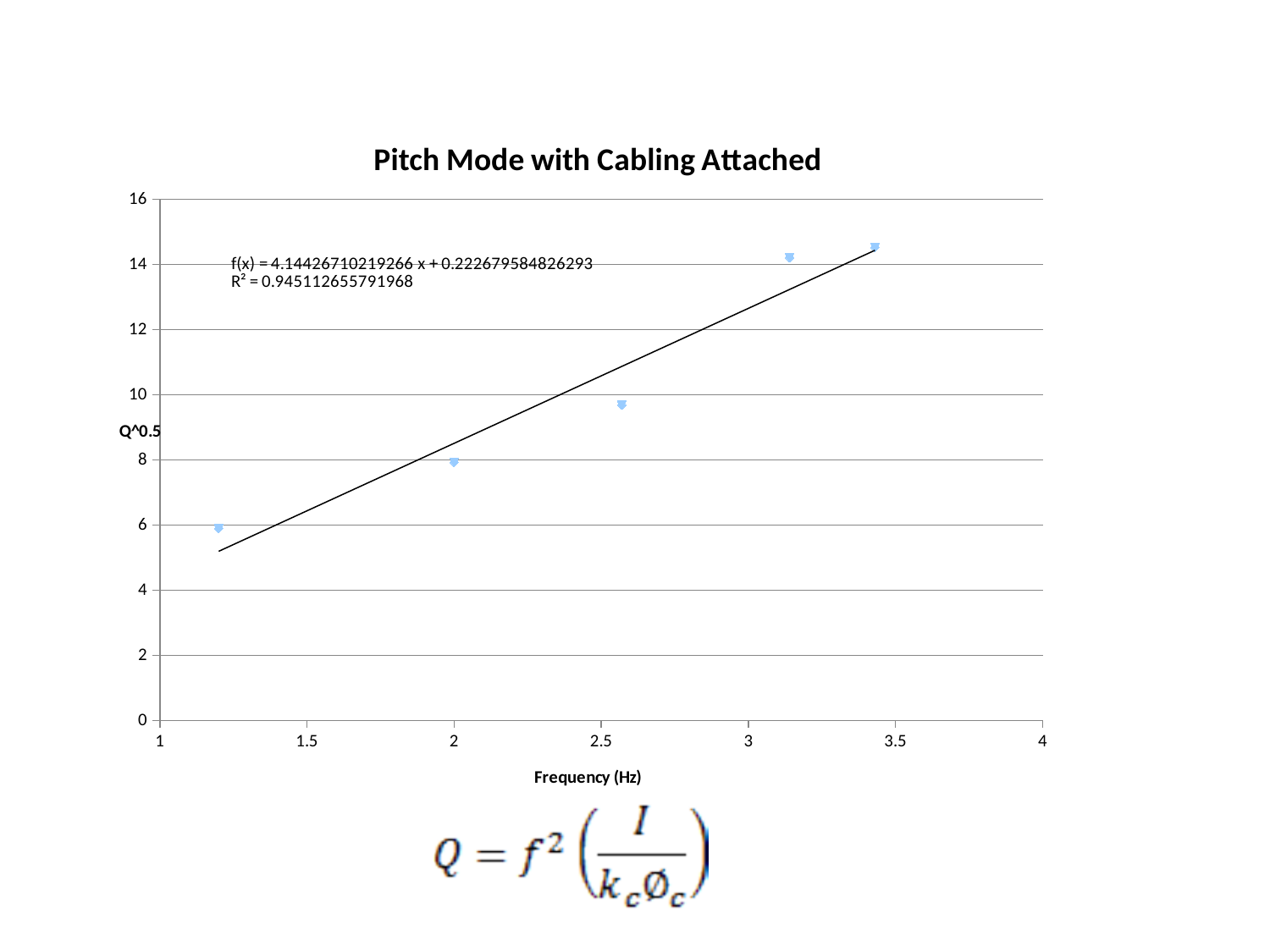
What is the label of the x axis? Frequency (Hz) Is the Q^0.5 value for the rightmost data point greater or less than 14? greater What kind of chart is shown on the slide? scatter chart Which data point has the lowest Q^0.5 value, the leftmost or the rightmost? the leftmost Is the Q^0.5 value for the data point at 2 Hz greater or less than 6? greater What is the title of the chart? Pitch Mode with Cabling Attached What is the slope of the fitted line f(x) printed on the chart? 4.14426710219266 Is the Q^0.5 value for the leftmost data point greater or less than 4? greater What is the R² value printed on the chart for the trendline? 0.945112655791968 How many data points are plotted on the chart? 5 Do the plotted Q^0.5 values rise or fall as frequency increases along the x axis? rise